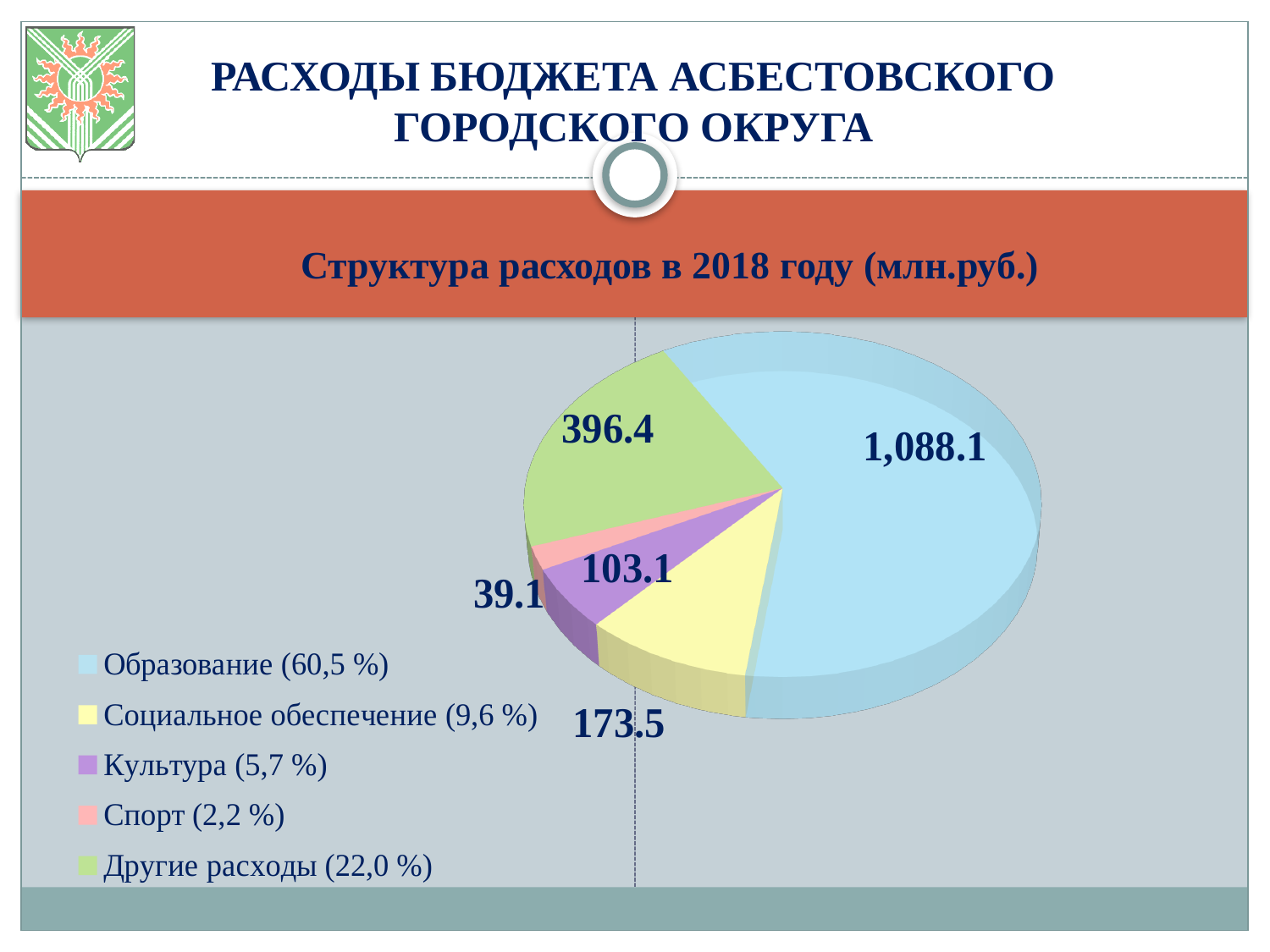
What is the value for Социальное обеспечение in the pie chart? 173.5 What is the value for Образование in the pie chart? 1,088.1 What kind of chart is shown on the slide? pie chart How many categories does the pie chart have? 5 What share of the pie does Другие расходы represent, according to the legend? 22,0 % What is the difference between the values for Образование and Другие расходы? 691.7 Which is larger, the value for Культура or the value for Спорт? Культура What is the value for Спорт in the pie chart? 39.1 What is the value for Другие расходы in the pie chart? 396.4 What is the difference between the values for Социальное обеспечение and Культура? 70.4 Which category has the smallest slice of the pie chart? Спорт Which category has the largest slice of the pie chart? Образование